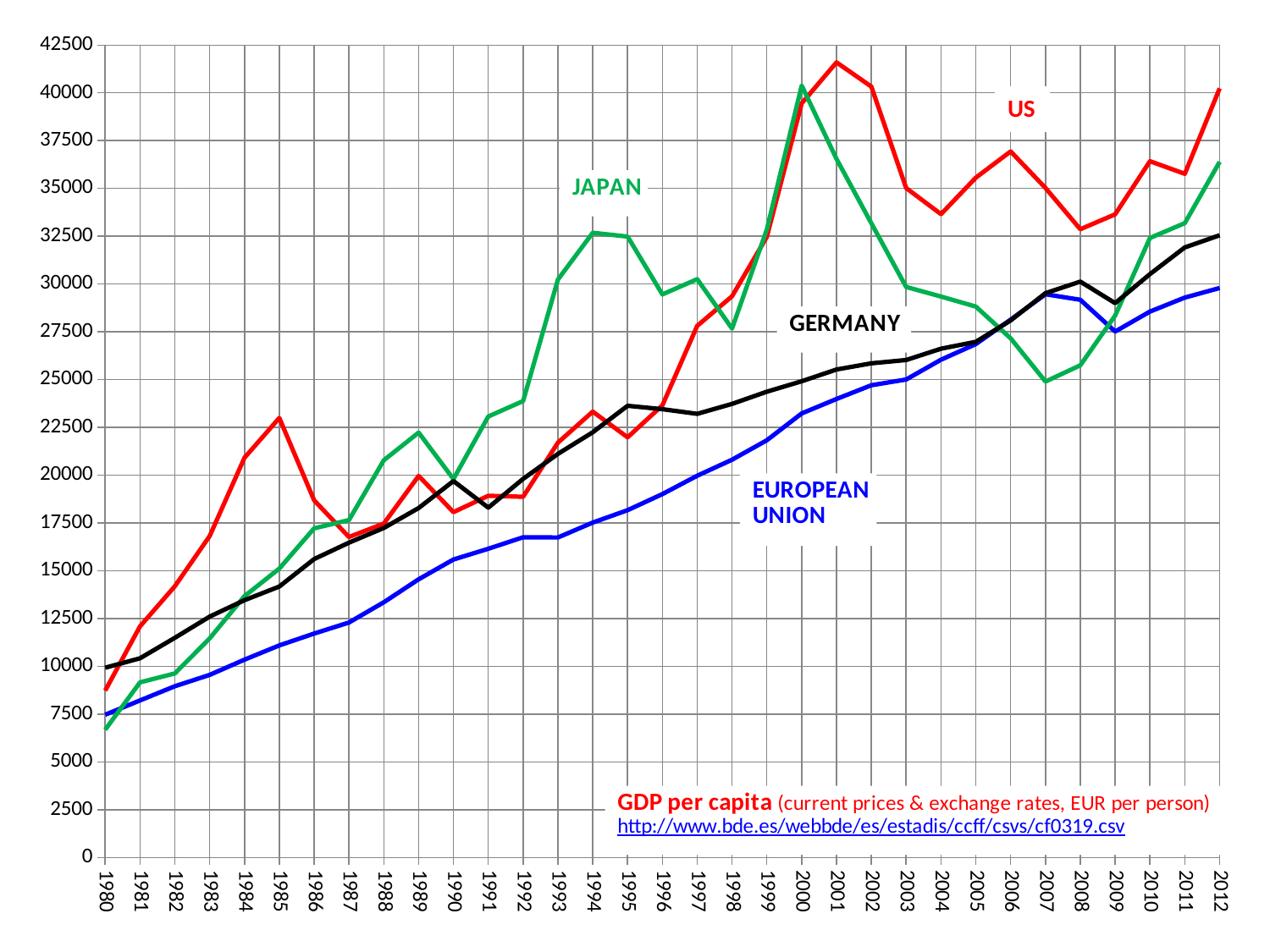
Which series has the lowest value in 2012? EUROPEAN UNION In 2007, which is larger: the value for GERMANY or the value for JAPAN? GERMANY Is the value for US in 2001 greater or less than 40000? greater Which series has the highest value in 2001? US What kind of chart is shown on the slide? line chart Is the value for EUROPEAN UNION in 2012 greater or less than 27500? greater How many series are plotted on the chart? 4 Does the EUROPEAN UNION line generally rise or fall from 1980 to 2012? rise Is the value for JAPAN in 1980 greater or less than 7500? less What colour is the JAPAN line on the chart? green How many years are shown along the x axis of the chart? 33